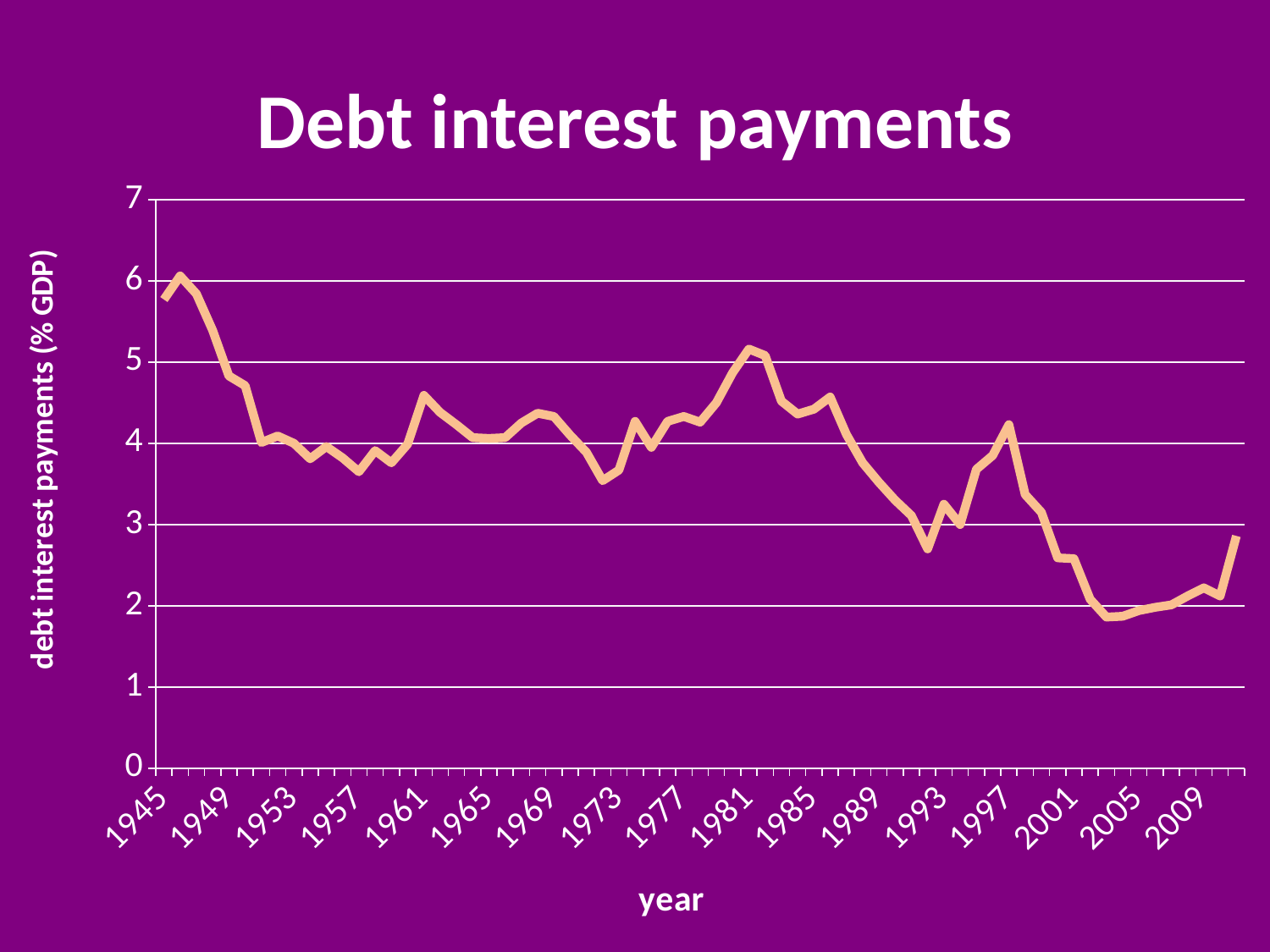
Is the value for 1973 greater or less than 4? less What kind of chart is shown on the slide? line chart Is the value for 1961 greater or less than 4? greater Overall, do the values rise or fall from 1945 to 2009? fall Is the value for 1993 greater or less than 3? greater Do the values rise or fall between 1997 and 2004? fall What is the title of the chart? Debt interest payments Which year has a higher value, 1945 or 2009? 1945 Which year has a higher value, 1981 or 1993? 1981 What is the label on the vertical axis of the chart? debt interest payments (% GDP)